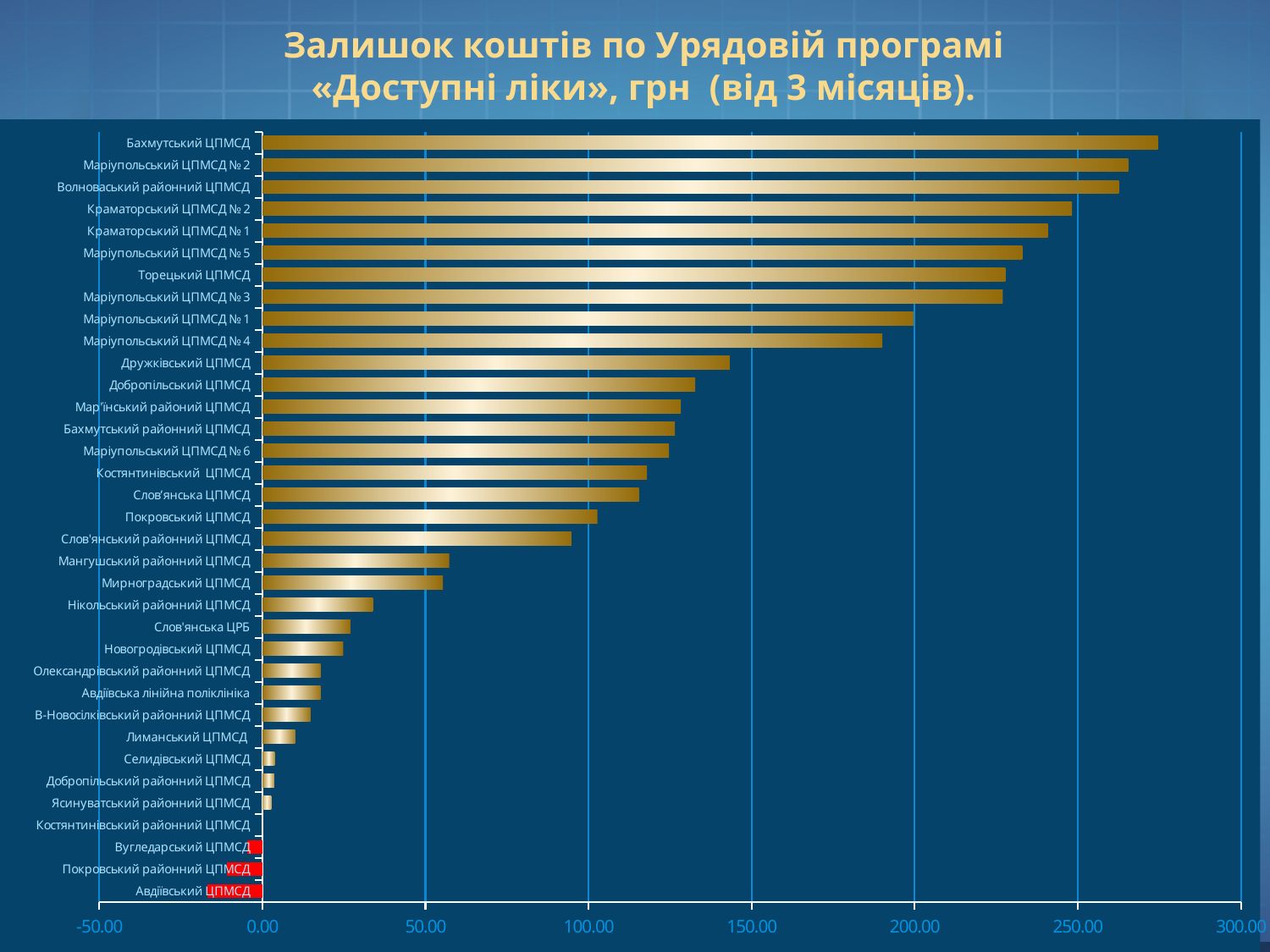
What kind of chart is shown on the slide? bar chart Is the value for Торецький ЦПМСД greater or less than 200.00? greater Is the value for Дружківський ЦПМСД greater or less than 150.00? less How many categories (institutions) are plotted on the chart? 35 Which institution has the highest value on the chart? Бахмутський ЦПМСД Which institution has the lowest value on the chart? Авдіївський ЦПМСД What is the title of the chart? Залишок коштів по Урядовій програмі «Доступні ліки», грн (від 3 місяців). Is the value for Слов'янський районний ЦПМСД greater or less than 100.00? less Do the bar values increase or decrease going from the top of the chart to the bottom? decrease Which has the larger value: Покровський ЦПМСД or Мирноградський ЦПМСД? Покровський ЦПМСД